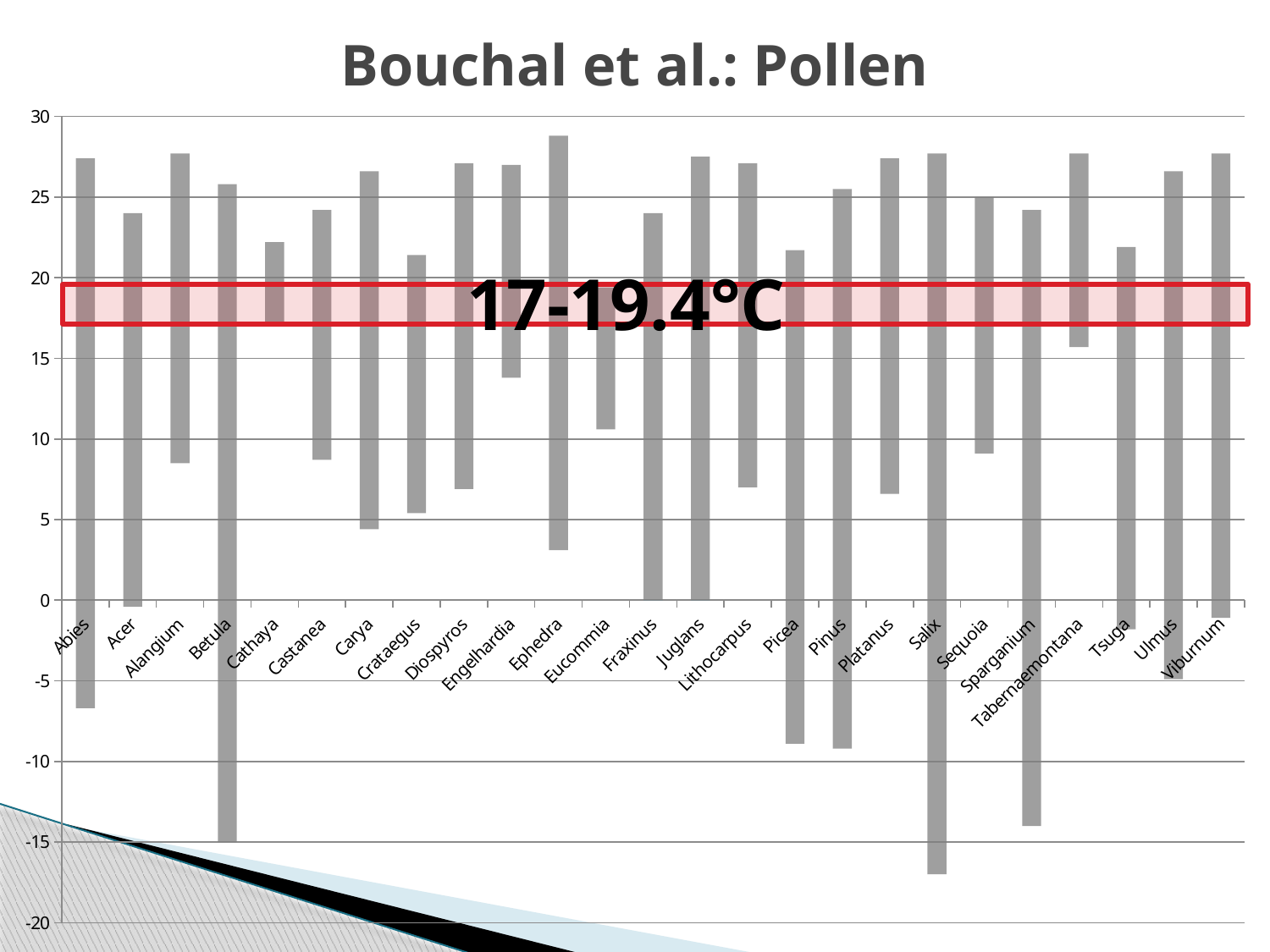
Which taxon's bar extends to the lowest value on the chart? Salix How many pollen taxa (categories) are plotted along the x axis? 25 Is the bottom of the bar for Salix greater or less than -15? less What temperature range is written in the red highlighted band across the chart? 17-19.4°C Which bar extends lower, Salix or Betula? Salix Is the bottom of the bar for Picea greater or less than -5? less Which taxon's bar reaches the highest value on the chart? Ephedra Is the bottom of the bar for Tabernaemontana greater or less than 10? greater What kind of chart is shown on the slide? bar chart What is the title of the slide's chart? Bouchal et al.: Pollen